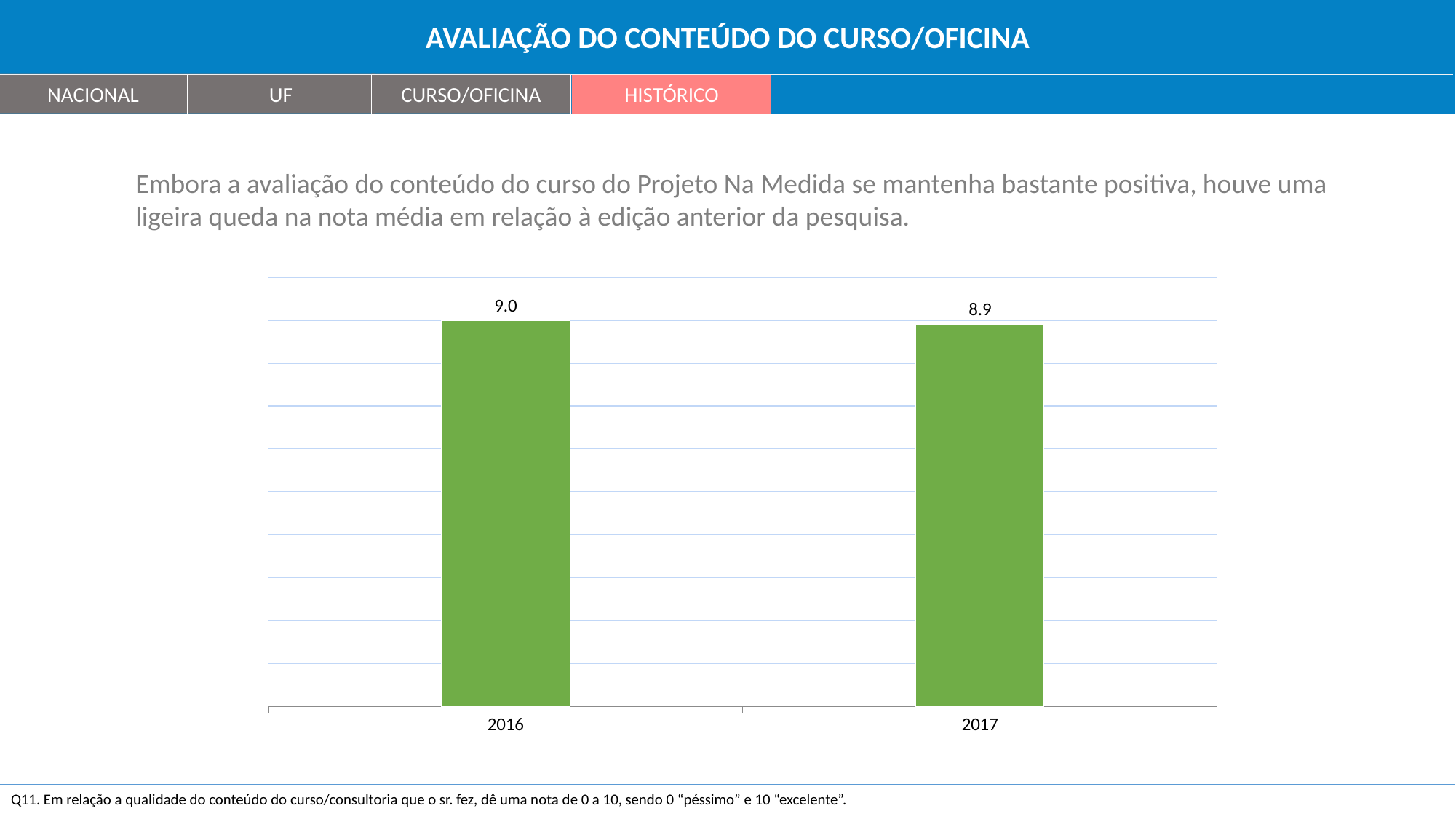
What colour are the bars in the chart? Green Which tab is highlighted in the navigation bar above the chart? HISTÓRICO Which year has the highest value? 2016 What is the value for 2016? 9.0 Which is larger, the value for 2016 or the value for 2017? 2016 Do the values rise or fall from 2016 to 2017? Fall What is the difference between the values for 2016 and 2017? 0.1 Which year has the lowest value? 2017 What is the value for 2017? 8.9 How many categories are shown on the x axis? 2 What kind of chart is shown on the slide? Bar chart